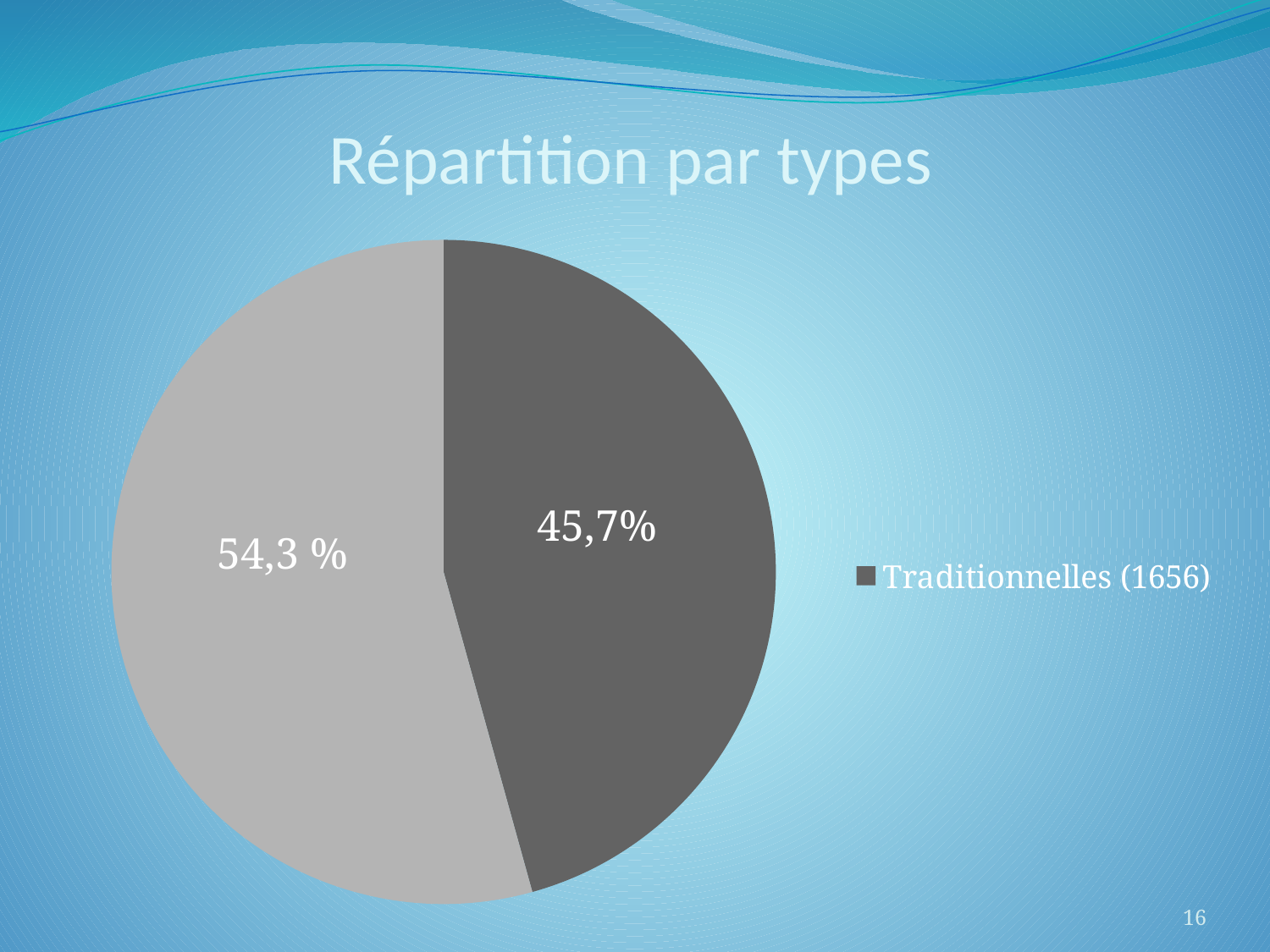
What number is shown in parentheses next to Traditionnelles in the legend? 1656 Which slice is larger, the Traditionnelles slice or the light grey slice? the light grey slice Is the share of the Traditionnelles slice greater or less than 50%? less What is the title of the chart? Répartition par types What is the difference in percentage points between the light grey slice and the Traditionnelles slice? 8,6 What kind of chart is shown on the slide? pie chart How many slices does the pie chart have? 2 What share of the pie does the Traditionnelles slice represent? 45,7% What colour is the Traditionnelles slice? dark grey What percentage is printed on the light grey slice of the pie? 54,3 % Which slice of the pie is the smallest? Traditionnelles